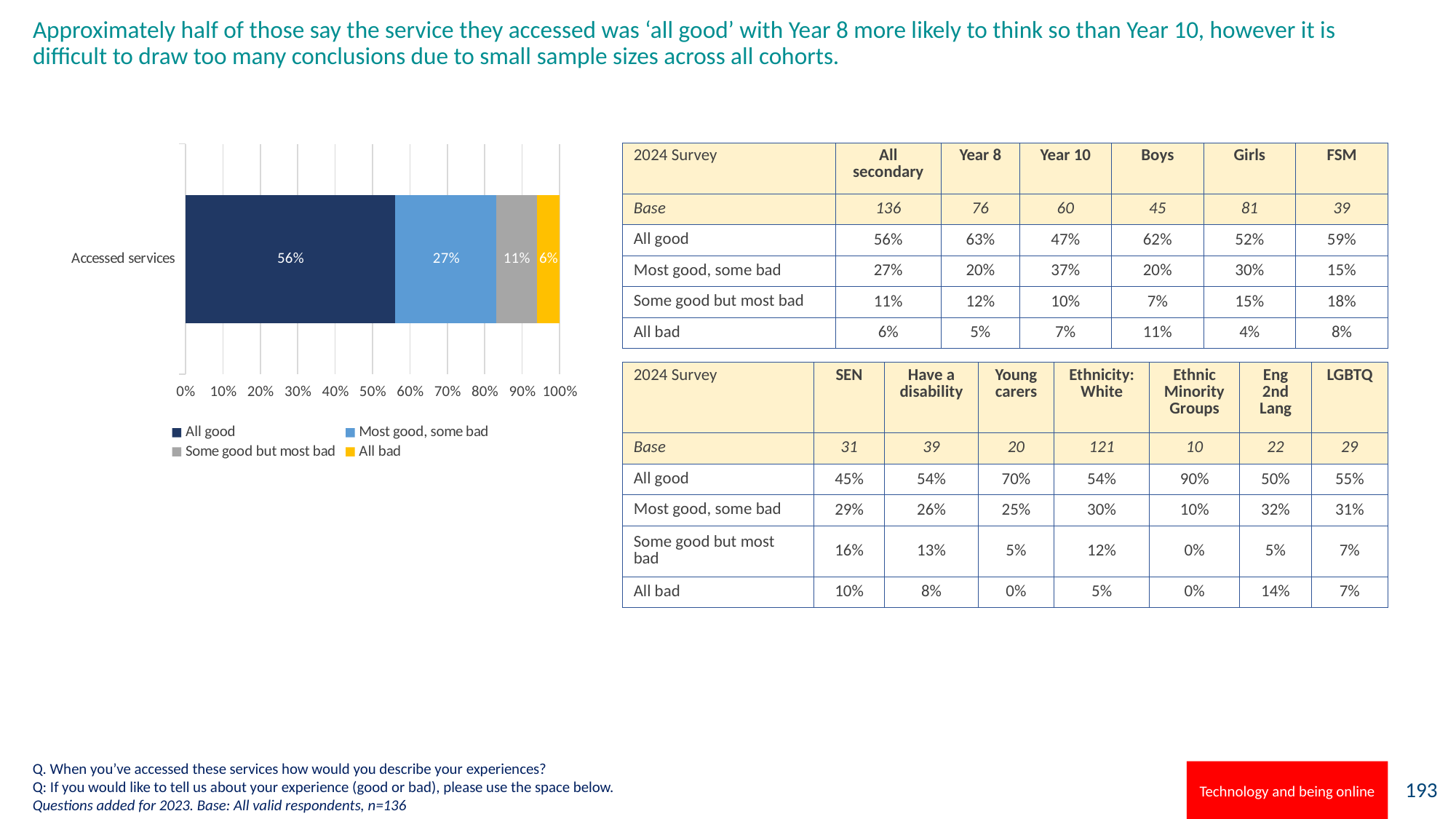
What percentage of the 'Accessed services' bar is 'All good'? 56% Which series has the smallest share of the 'Accessed services' bar? All bad Which segment is larger in the bar: 'Some good but most bad' or 'All bad'? Some good but most bad What is the difference between the 'All good' and 'Most good, some bad' segments of the bar? 29% What percentage of the 'Accessed services' bar is 'Some good but most bad'? 11% What is the total of the 'Accessed services' stacked bar? 100% What kind of chart is shown on the slide? Stacked bar chart What percentage of the 'Accessed services' bar is 'Most good, some bad'? 27% Which series has the largest share of the 'Accessed services' bar? All good How many series does the chart legend list? 4 What colour is the 'All bad' segment in the chart? Yellow What percentage of the 'Accessed services' bar is 'All bad'? 6%